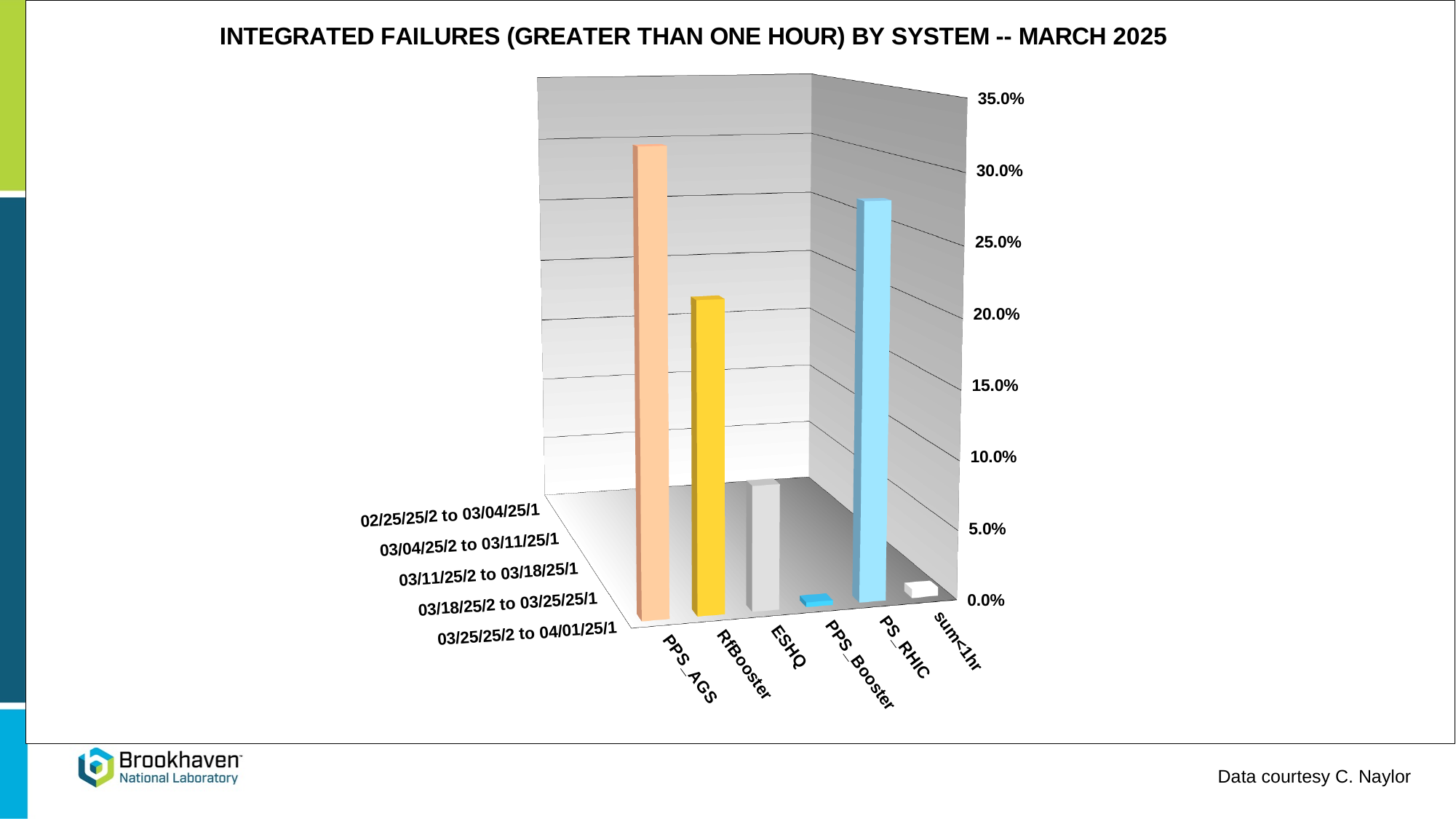
Which is larger, the value for RfBooster or the value for ESHQ? RfBooster What is the highest value labelled on the vertical axis of the chart? 35.0% Is the value for PPS_AGS greater or less than 25.0%? greater Which system has the tallest bar in the chart? PPS_AGS Is the value for ESHQ greater or less than 15.0%? less What is the title of the chart? INTEGRATED FAILURES (GREATER THAN ONE HOUR) BY SYSTEM -- MARCH 2025 Is the value for PPS_Booster greater or less than 5.0%? less What kind of chart is shown on the slide? bar chart How many system categories are shown along the horizontal axis of the chart? 6 Which is larger, the value for PPS_AGS or the value for PS_RHIC? PPS_AGS